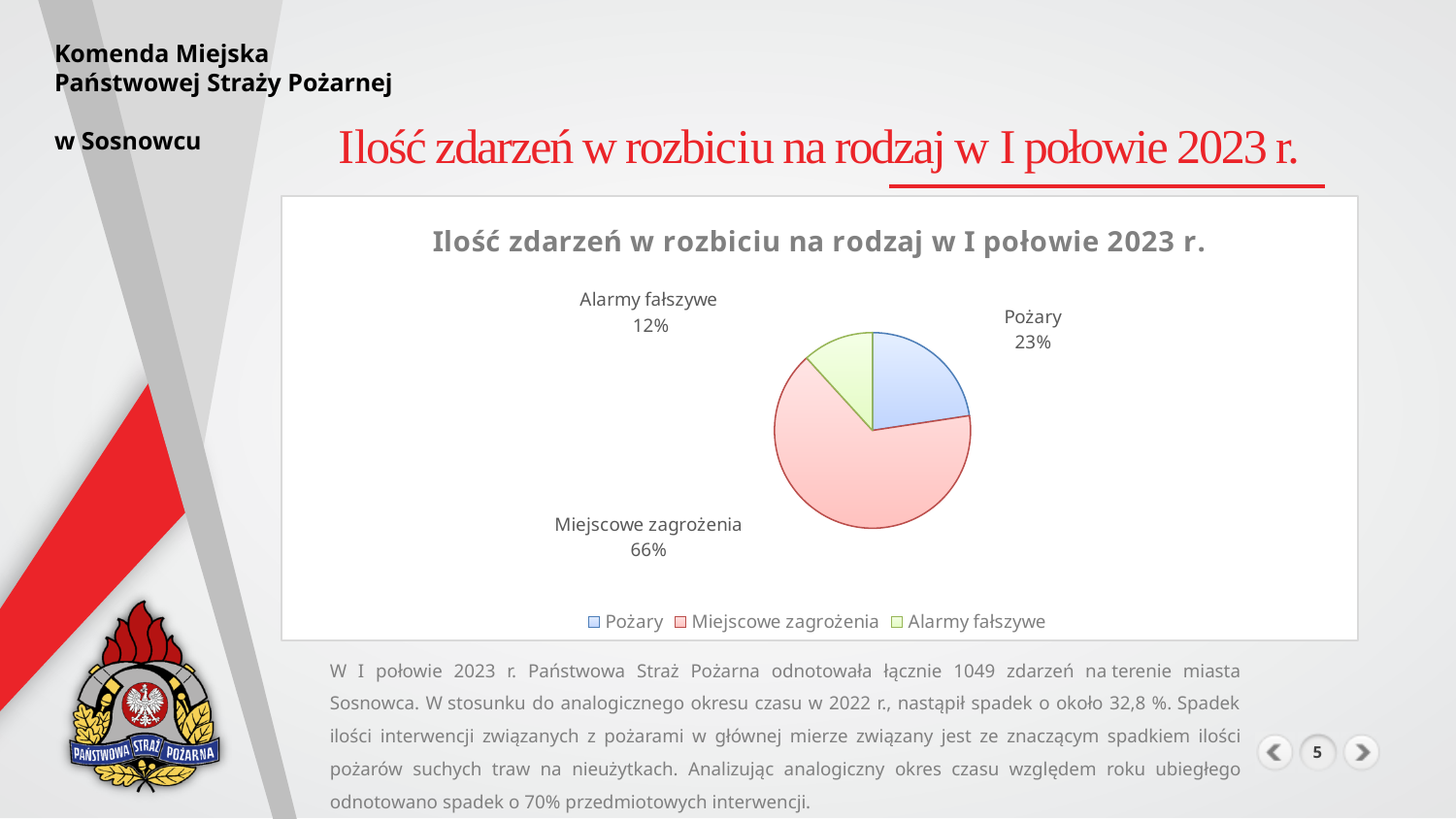
What is the difference in percentage points between the Miejscowe zagrożenia share and the Pożary share? 43 percentage points What share of the pie does Miejscowe zagrożenia have? 66% What is the title of the chart? Ilość zdarzeń w rozbiciu na rodzaj w I połowie 2023 r. How many categories are shown in the pie chart? 3 Which is larger, the share for Pożary or the share for Alarmy fałszywe? Pożary What kind of chart is shown on the slide? pie chart Which category has the largest slice of the pie? Miejscowe zagrożenia Which category has the smallest slice of the pie? Alarmy fałszywe What share of the pie does Pożary have? 23% What share of the pie does Alarmy fałszywe have? 12% What colour is the Miejscowe zagrożenia slice? pink/red How many entries does the legend list? 3